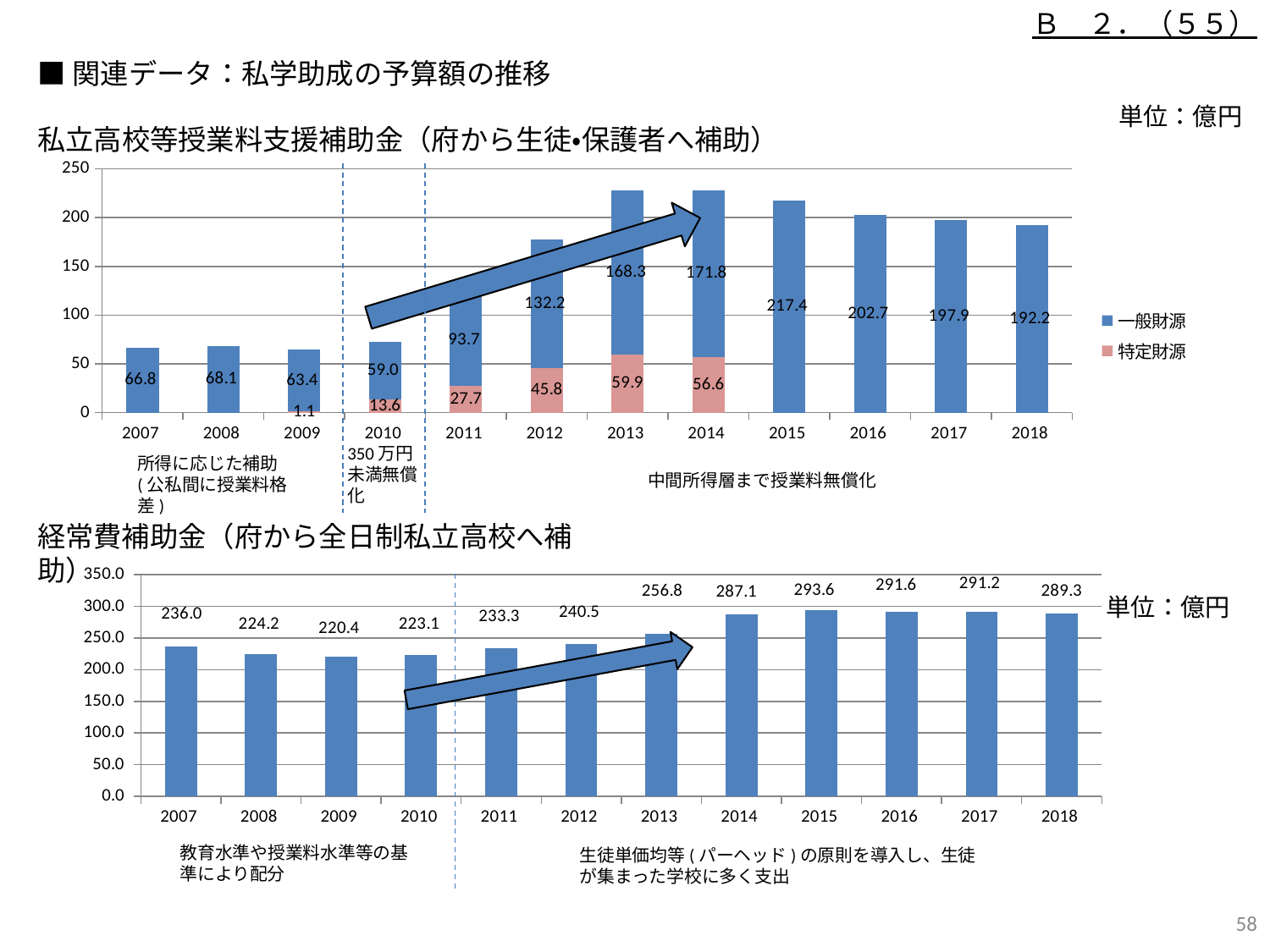
In the top chart (私立高校等授業料支援補助金), what is the difference between the 一般財源 values for 2015 and 2018? 25.2 In the top chart (私立高校等授業料支援補助金), how many series does the legend list? 2 In the bottom chart (経常費補助金), which year has the lowest value? 2009 How many years are shown on the x axis of the bottom chart (経常費補助金)? 12 In the top chart (私立高校等授業料支援補助金), what is the 特定財源 value for 2013? 59.9 In the top chart (私立高校等授業料支援補助金), what is the total of the stacked bar for 2011? 121.4 In the bottom chart (経常費補助金), which year has the highest value? 2015 In the bottom chart (経常費補助金), what is the difference between the values for 2013 and 2012? 16.3 In the top chart (私立高校等授業料支援補助金), what is the 一般財源 value for 2012? 132.2 In the top chart (私立高校等授業料支援補助金), what colour represents 特定財源 in the legend? Pink In the top chart (私立高校等授業料支援補助金), which is larger, the 特定財源 value for 2012 or for 2014? 2014 In the bottom chart (経常費補助金), what is the value for 2014? 287.1